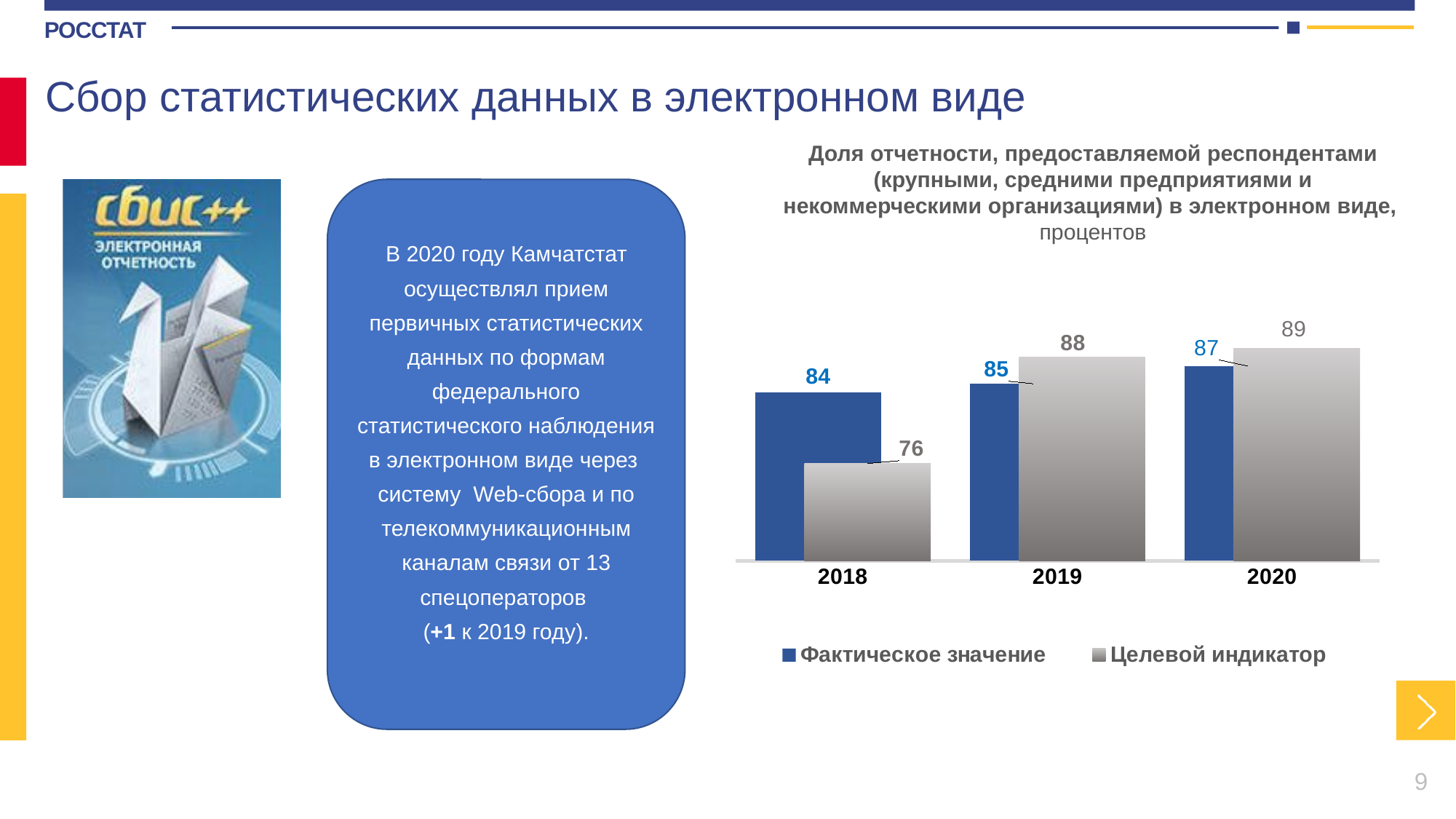
What is the value of 'Фактическое значение' for 2020? 87 What is the difference between 'Целевой индикатор' and 'Фактическое значение' in 2019? 3 What is the value of 'Целевой индикатор' for 2018? 76 What is the value of 'Фактическое значение' for 2018? 84 How many series does the chart legend list? 2 What kind of chart is shown on the slide? bar chart Which is larger in 2018: 'Фактическое значение' or 'Целевой индикатор'? Фактическое значение Does 'Фактическое значение' rise or fall from 2018 to 2020? rise How many years are shown on the x axis of the chart? 3 In which year is 'Целевой индикатор' the highest? 2020 In which year is 'Фактическое значение' the lowest? 2018 What is the value of 'Целевой индикатор' for 2019? 88